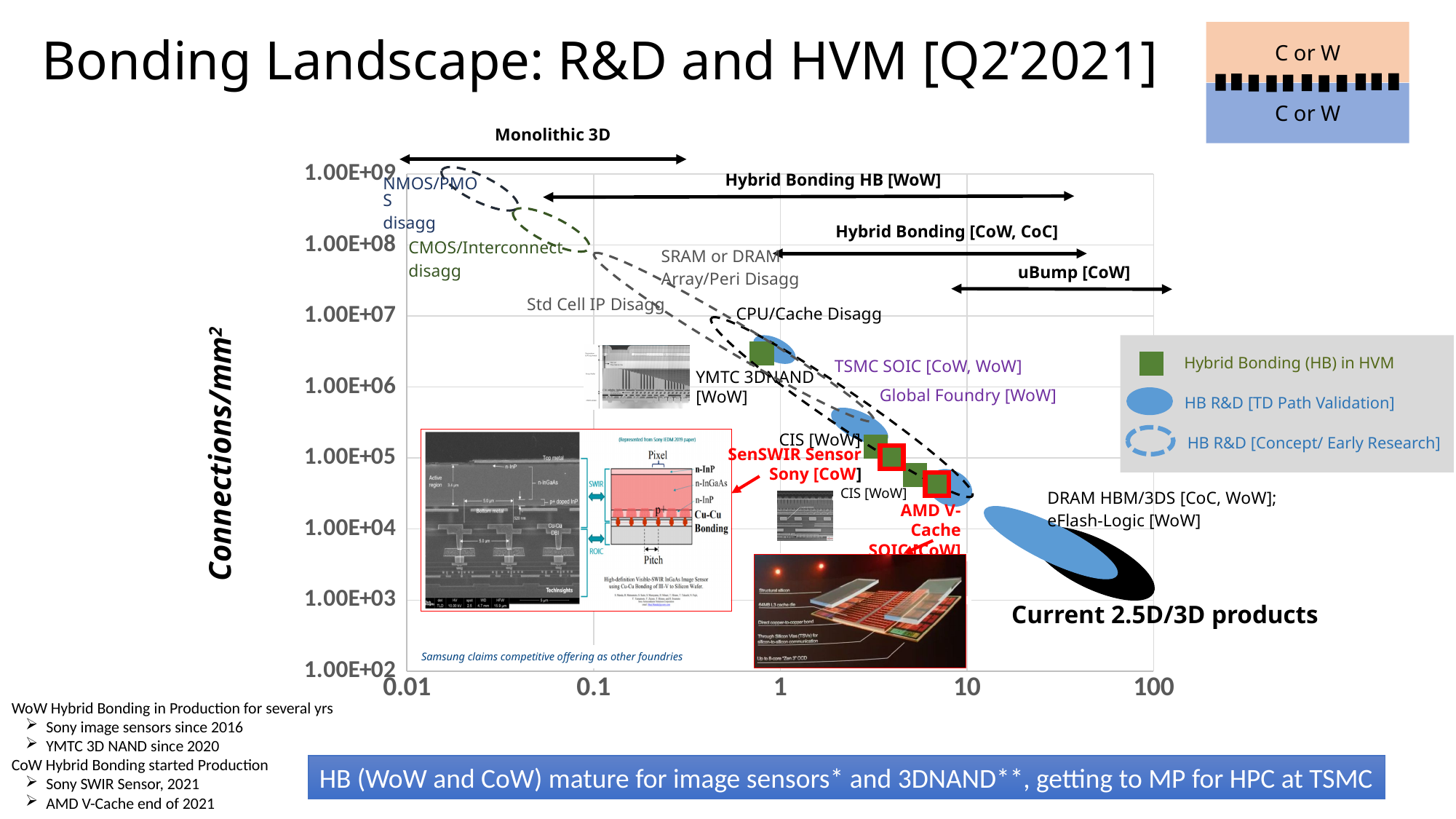
Is the Connections/mm² value for YMTC 3DNAND [WoW] greater or less than 1.00E+07? less Do the plotted Connections/mm² values rise or fall as you move right along the x axis? fall Which has the higher Connections/mm² value, YMTC 3DNAND [WoW] or AMD V-Cache SOIC [CoW]? YMTC 3DNAND [WoW] What is the label of the vertical axis of the chart? Connections/mm² How many tick labels are shown on the x axis of the chart? 5 Is the x-axis position of the Current 2.5D/3D products bubble greater or less than 10? greater Is the Connections/mm² value for the SenSWIR Sensor Sony [CoW] greater or less than 1.00E+04? greater How many entries does the chart legend list? 3 What kind of chart is shown on the slide? Scatter (bubble) chart Which legend entry is represented by a green square? Hybrid Bonding (HB) in HVM